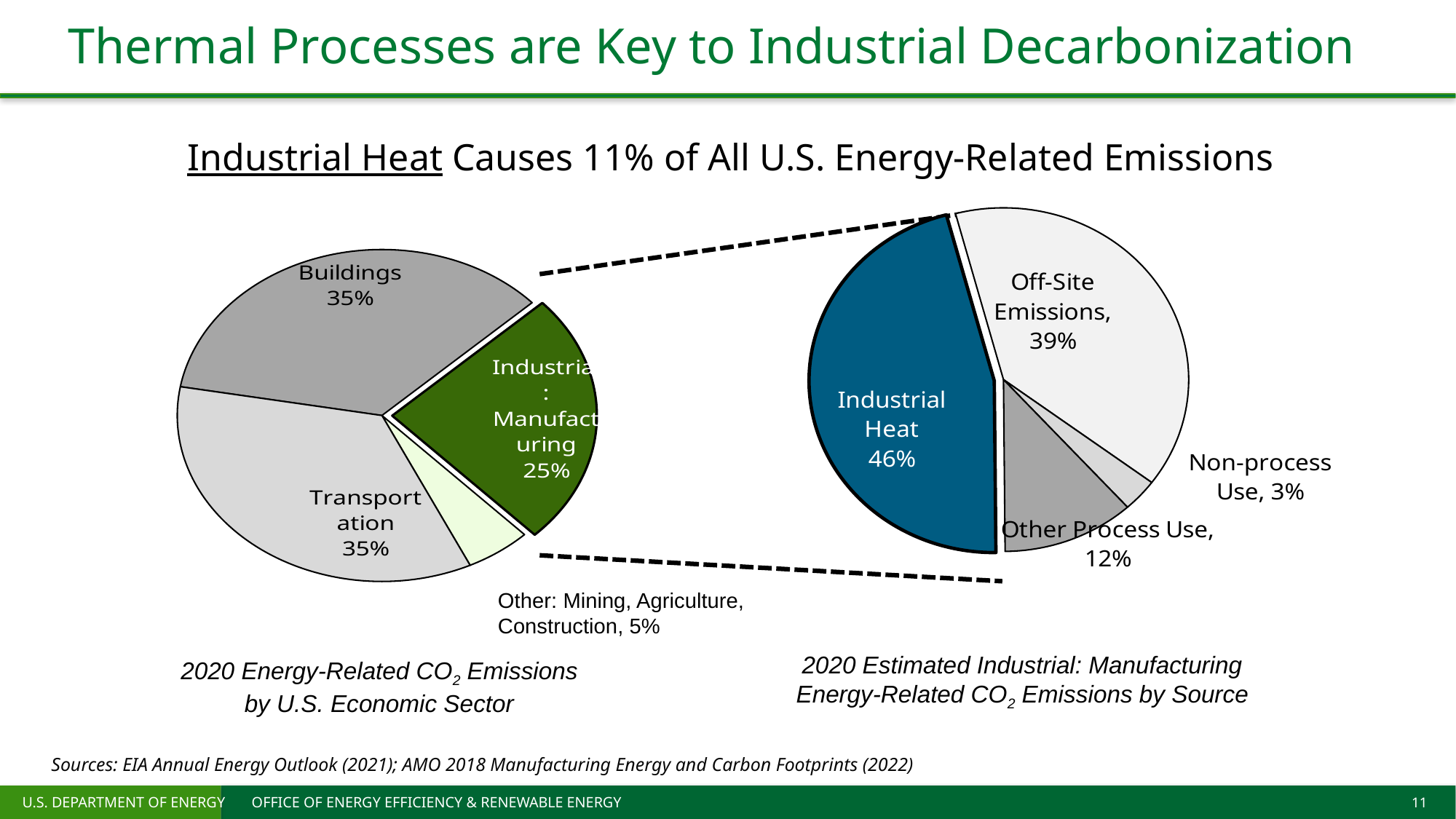
In the right pie chart (2020 Estimated Industrial: Manufacturing Energy-Related CO2 Emissions by Source), what share is Industrial Heat? 46% In the left pie chart (2020 Energy-Related CO2 Emissions by U.S. Economic Sector), what share is Other: Mining, Agriculture, Construction? 5% In the left pie chart (2020 Energy-Related CO2 Emissions by U.S. Economic Sector), what is the difference between the Buildings share and the Industrial: Manufacturing share? 10% In the left pie chart (2020 Energy-Related CO2 Emissions by U.S. Economic Sector), which category has the smallest share? Other: Mining, Agriculture, Construction In the right pie chart (2020 Estimated Industrial: Manufacturing Energy-Related CO2 Emissions by Source), which source has the largest share? Industrial Heat In the left pie chart (2020 Energy-Related CO2 Emissions by U.S. Economic Sector), what share is Buildings? 35% In the left pie chart (2020 Energy-Related CO2 Emissions by U.S. Economic Sector), how many slices are there? 4 In the right pie chart (2020 Estimated Industrial: Manufacturing Energy-Related CO2 Emissions by Source), what share is Non-process Use? 3% In the left pie chart (2020 Energy-Related CO2 Emissions by U.S. Economic Sector), what share is Industrial: Manufacturing? 25% In the right pie chart (2020 Estimated Industrial: Manufacturing Energy-Related CO2 Emissions by Source), what share is Off-Site Emissions? 39% In the right pie chart (2020 Estimated Industrial: Manufacturing Energy-Related CO2 Emissions by Source), which is larger, Other Process Use or Non-process Use? Other Process Use What type of chart is used on this slide? Pie chart